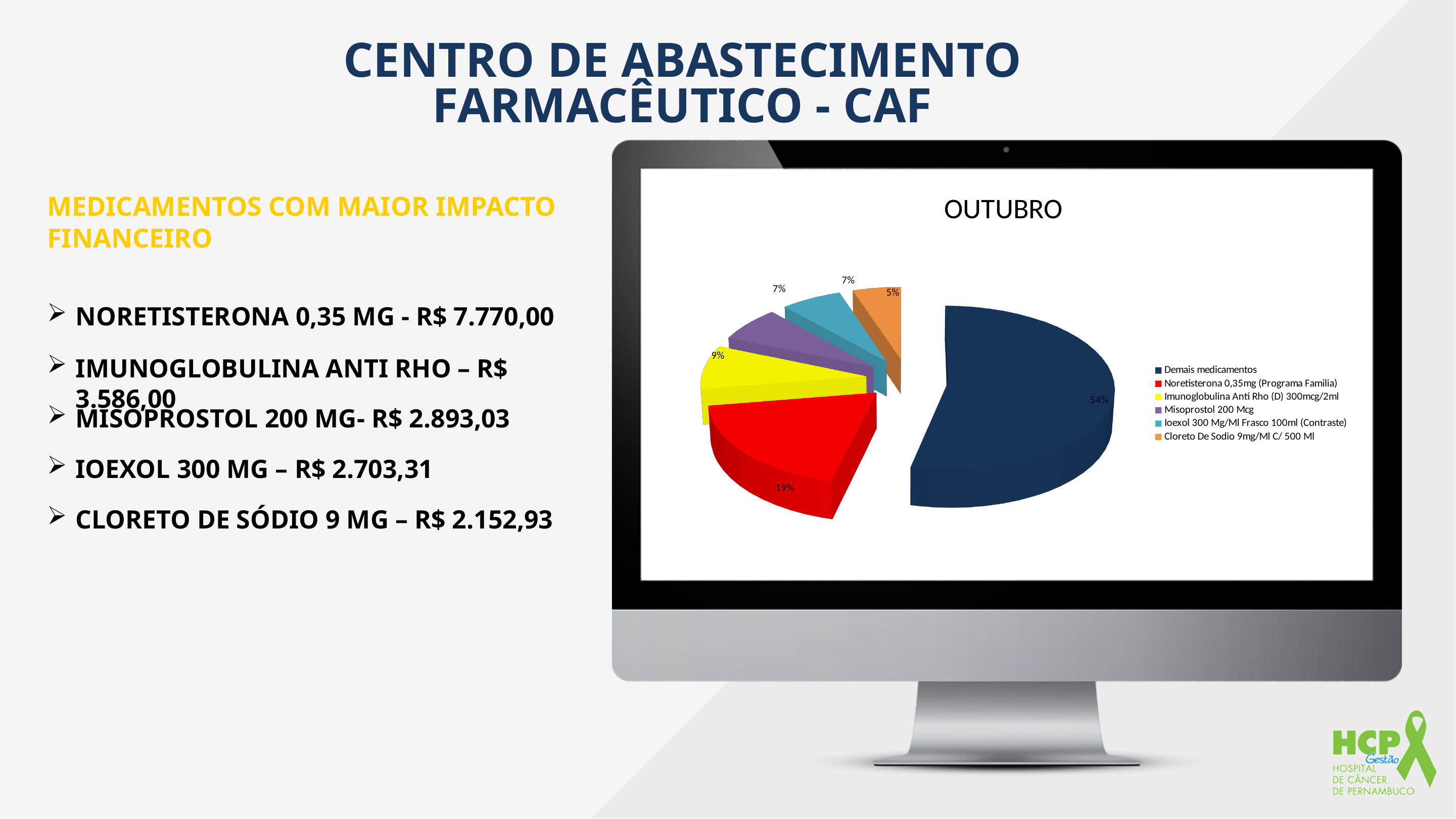
Which is larger, the slice for Imunoglobulina Anti Rho (D) 300mcg/2ml or the slice for Cloreto De Sodio 9mg/Ml C/ 500 Ml? Imunoglobulina Anti Rho (D) 300mcg/2ml Which category has the largest slice of the pie? Demais medicamentos How many categories does the legend list? 6 What colour is the slice for Noretisterona 0,35mg (Programa Familia)? red What kind of chart is shown on the slide? pie chart What share of the pie does Imunoglobulina Anti Rho (D) 300mcg/2ml represent? 9% What is the difference in percentage points between Demais medicamentos and Noretisterona 0,35mg (Programa Familia)? 35 What share of the pie does Cloreto De Sodio 9mg/Ml C/ 500 Ml represent? 5% Which category has the smallest slice of the pie? Cloreto De Sodio 9mg/Ml C/ 500 Ml What share of the pie does Noretisterona 0,35mg (Programa Familia) represent? 19% What is the title of the pie chart? OUTUBRO